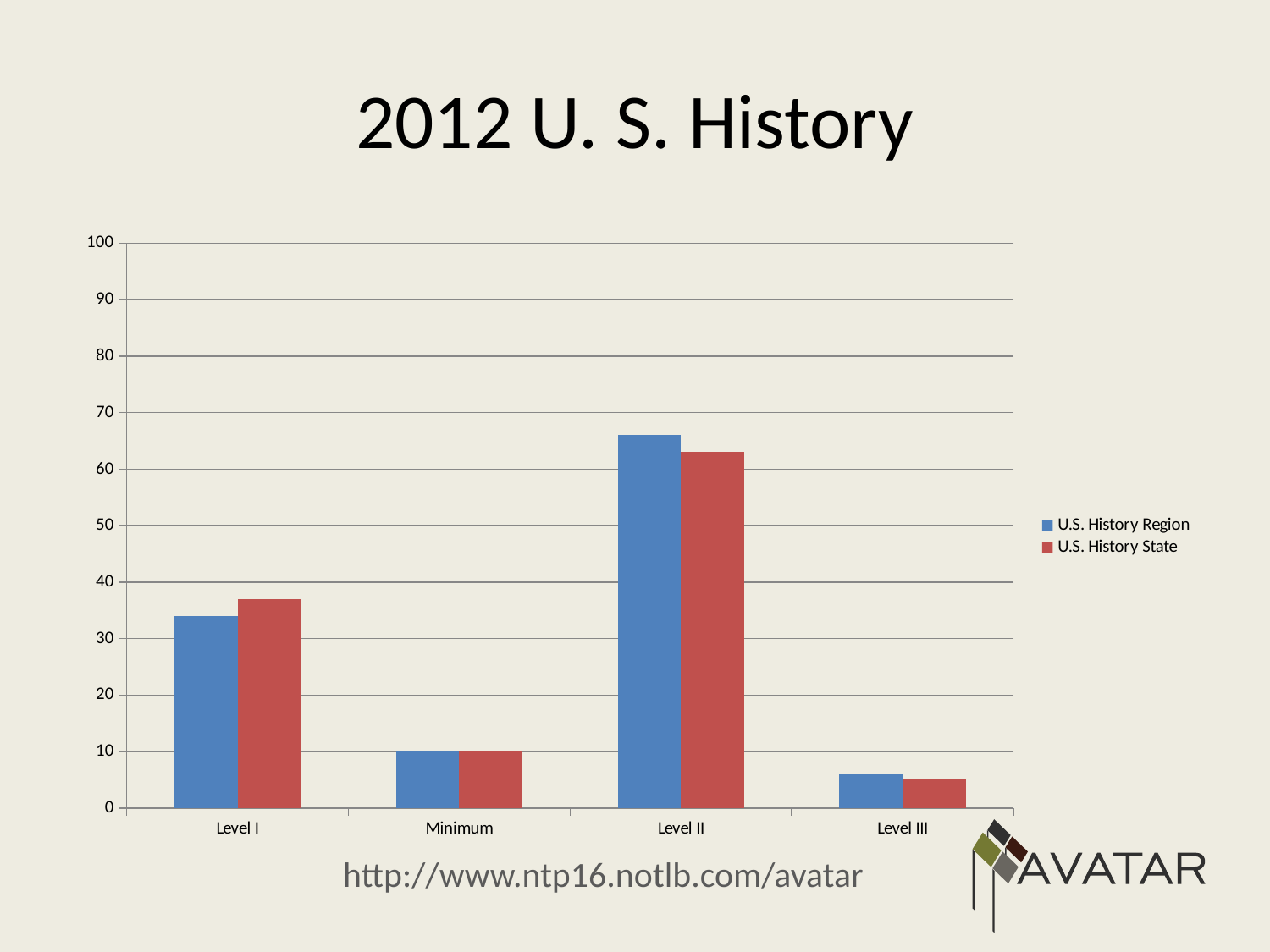
Which category has the highest value for U.S. History Region? Level II What kind of chart is shown on the slide? bar chart What is the title of the chart? 2012 U. S. History At Level II, which is larger: U.S. History Region or U.S. History State? U.S. History Region How many series does the legend list? 2 What is the value for U.S. History Region at Minimum? 10 At Level I, which is larger: U.S. History Region or U.S. History State? U.S. History State How many categories are shown on the x axis? 4 Which category has the lowest value for U.S. History State? Level III Is the value for U.S. History State at Level III greater or less than 10? less Which series is shown in red? U.S. History State Is the value for U.S. History Region at Level II greater or less than 60? greater